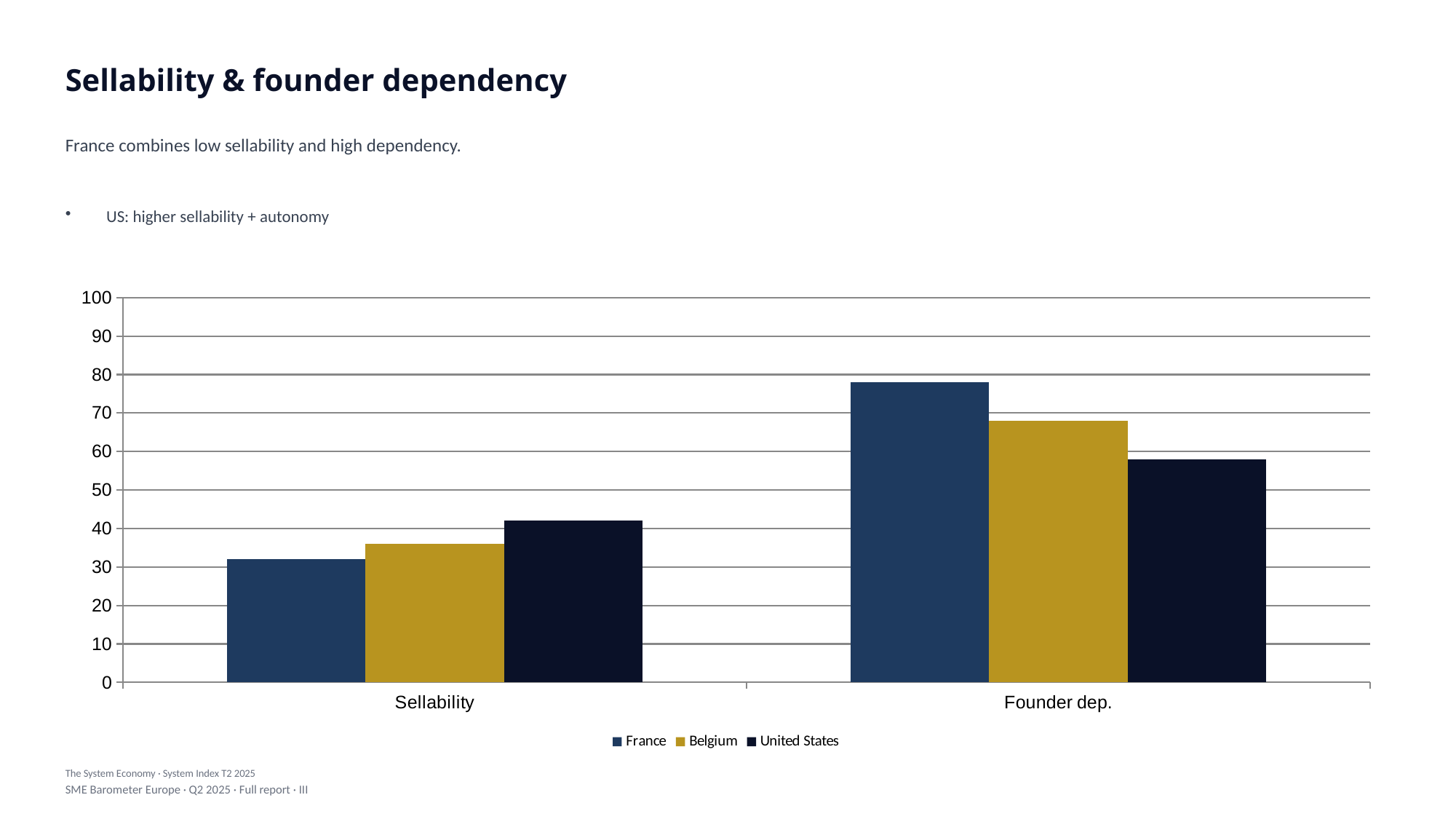
Which series has the lowest value for Sellability? France How many series does the legend list? 3 Is the value for United States in Sellability greater or less than 50? less How many categories are shown on the x axis? 2 Which series is shown in gold/yellow bars? Belgium What kind of chart is shown on the slide? bar chart Is the value for France in Founder dep. greater or less than 70? greater Which series has the lowest value for Founder dep.? United States Which series has the highest value for Founder dep.? France Which series has the highest value for Sellability? United States Is the value for Belgium in Founder dep. greater or less than 60? greater Which is larger: the France value for Sellability or the France value for Founder dep.? Founder dep.